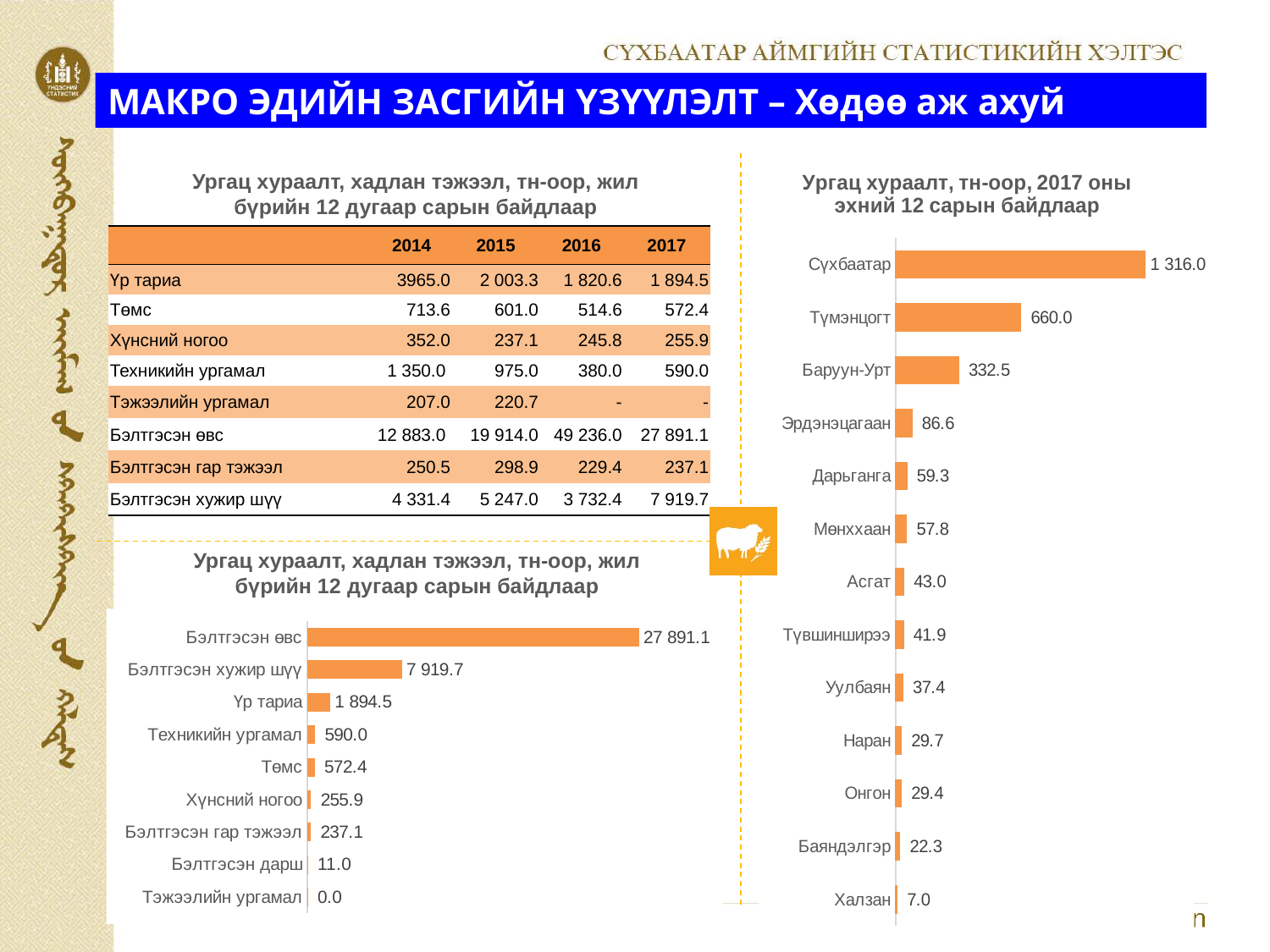
What type of chart is the right chart (Ургац хураалт, тн-оор, 2017)? Bar chart In the bottom-left chart (Ургац хураалт, хадлан тэжээл), which is larger, Хүнсний ногоо or Бэлтгэсэн гар тэжээл? Хүнсний ногоо In the bottom-left chart (Ургац хураалт, хадлан тэжээл), what is the value for Бэлтгэсэн хужир шүү? 7 919.7 In the right chart (Ургац хураалт, тн-оор, 2017), what is the difference between Сүхбаатар and Түмэнцогт? 656.0 In the right chart (Ургац хураалт, тн-оор, 2017), how many soums are plotted? 13 In the bottom-left chart (Ургац хураалт, хадлан тэжээл), what is the difference between Техникийн ургамал and Төмс? 17.6 In the right chart (Ургац хураалт, тн-оор, 2017), what is the value for Баруун-Урт? 332.5 In the bottom-left chart (Ургац хураалт, хадлан тэжээл), what is the value for Бэлтгэсэн өвс? 27 891.1 In the bottom-left chart (Ургац хураалт, хадлан тэжээл), how many categories are plotted? 9 In the right chart (Ургац хураалт, тн-оор, 2017), what is the value for Сүхбаатар? 1 316.0 In the right chart (Ургац хураалт, тн-оор, 2017), which soum has the lowest value? Халзан In the bottom-left chart (Ургац хураалт, хадлан тэжээл), which category has the lowest value? Тэжээлийн ургамал